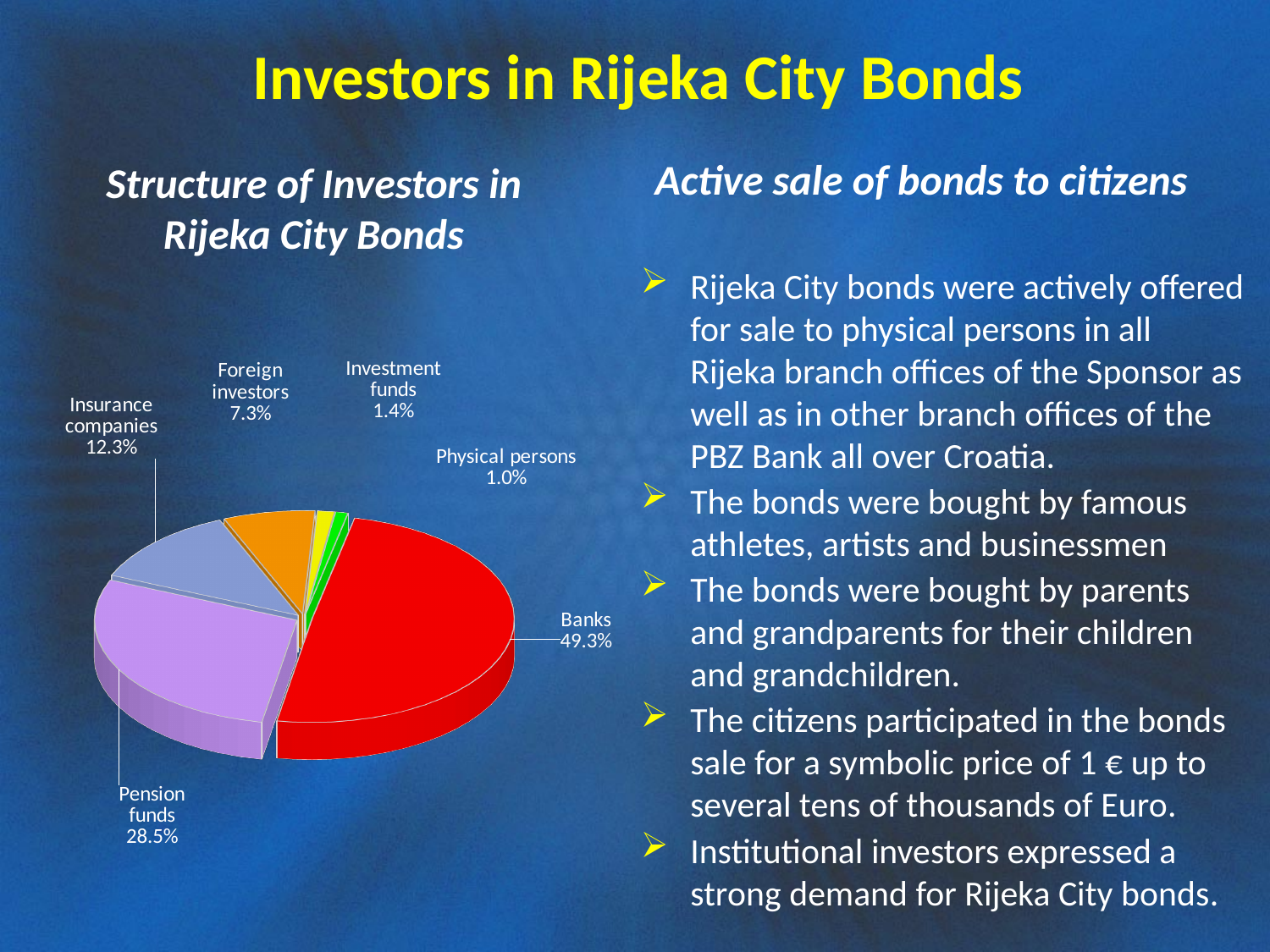
Which investor category has the smallest share in the pie chart? Physical persons What is the title of the pie chart? Structure of Investors in Rijeka City Bonds Which has a larger share, insurance companies or foreign investors? Insurance companies What share of investors in Rijeka City Bonds are banks? 49.3% Which investor category has the largest share in the pie chart? Banks What percentage of investors are foreign investors? 7.3% How many investor categories are shown in the pie chart? 6 What is the share of insurance companies in the structure of investors? 12.3% What is the difference in percentage points between the shares of banks and pension funds? 20.8 What kind of chart is shown on the slide? Pie chart What percentage of the pie chart is attributed to pension funds? 28.5% What share of the pie chart do physical persons represent? 1.0%